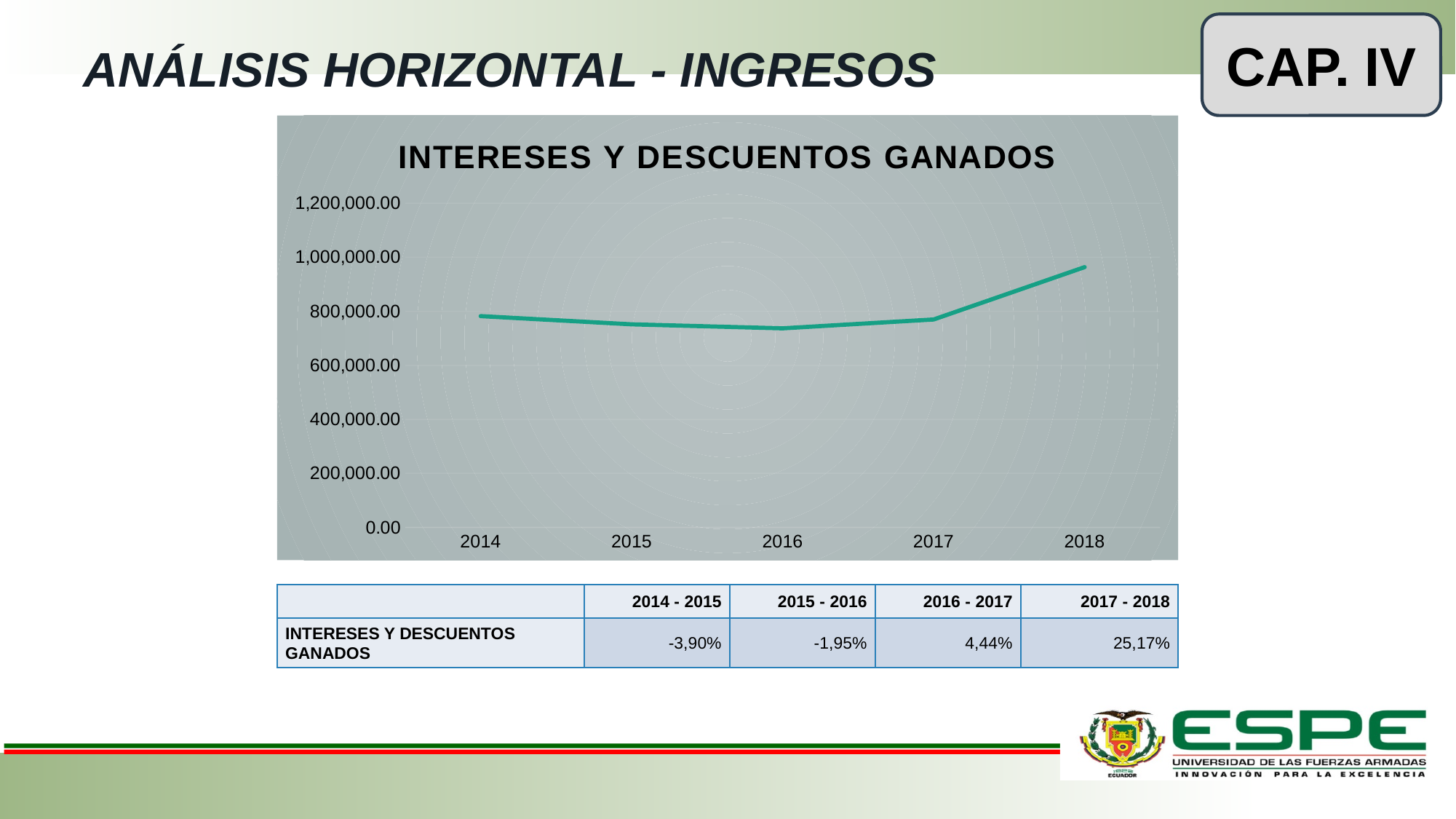
Is the value for 2014 greater or less than 600,000.00? greater Does the line rise or fall between 2017 and 2018? rise Which is larger, the value for 2014 or the value for 2018? 2018 Is the value for 2016 greater or less than 800,000.00? less Is the value for 2018 greater or less than 1,000,000.00? less Which year has the highest value in the chart? 2018 What is the title of the chart? INTERESES Y DESCUENTOS GANADOS Does the line rise or fall between 2014 and 2016? fall How many years are plotted on the x axis of the chart? 5 What kind of chart is shown on the slide? line chart Which year has the lowest value in the chart? 2016